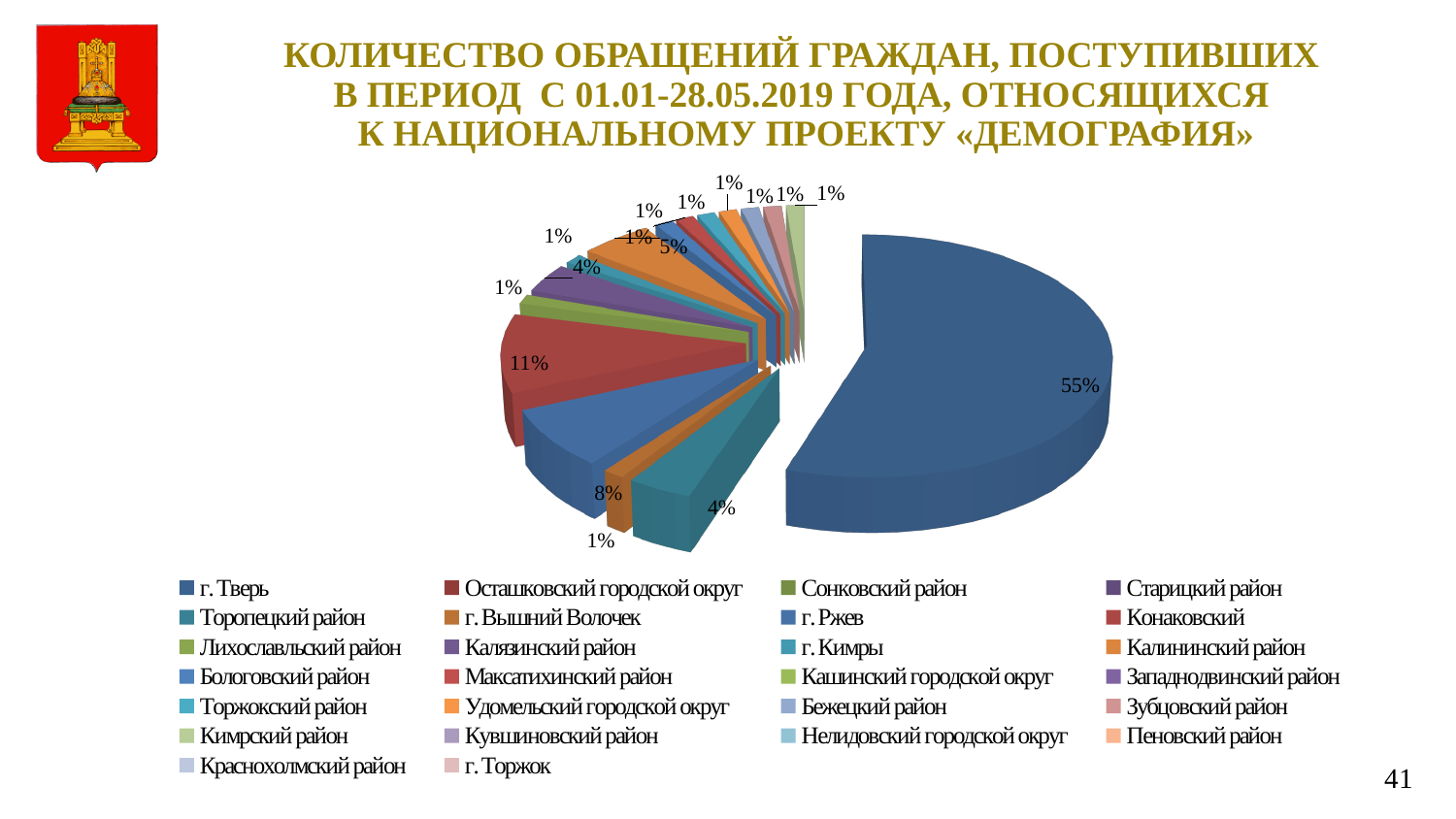
What share of the pie does г. Тверь account for? 55% What is the title of the chart on the slide? Количество обращений граждан, поступивших в период с 01.01-28.05.2019 года, относящихся к национальному проекту «Демография» Which is larger: the 8% slice or the 11% slice? the 11% slice What is the value of the largest slice of the pie chart? 55% Is the share for г. Тверь greater or less than 50%? greater What is the difference between the largest slice (55%) and the 11% slice? 44% Which category has the largest share of the pie chart? г. Тверь Where is the legend placed relative to the pie chart? below the chart What kind of chart is shown on the slide? pie chart What is the value of the second-largest slice of the pie chart? 11% How many categories does the legend of the pie chart list? 26